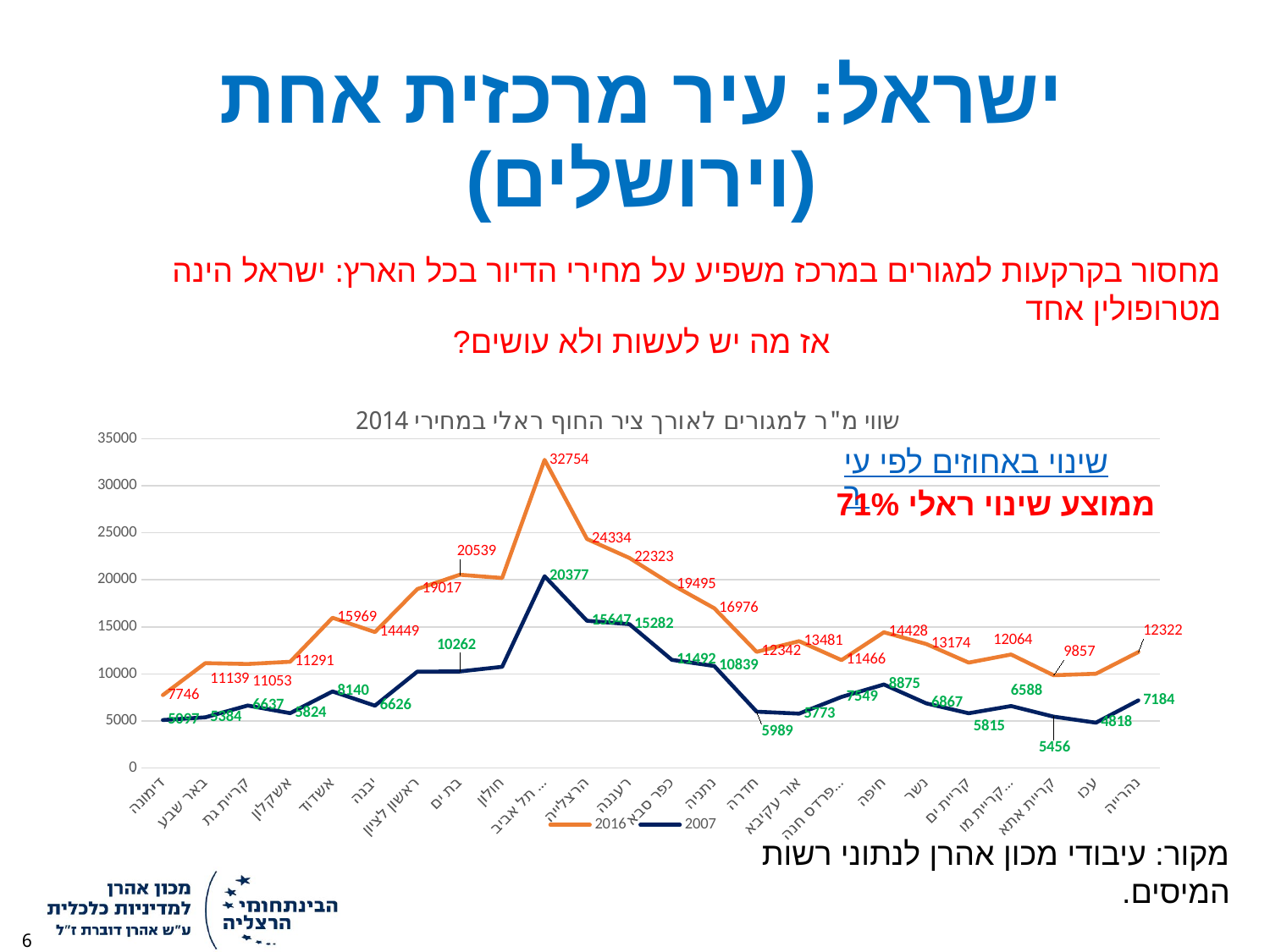
What is the difference between the 2016 and 2007 values for תל אביב? 12377 Which city has the highest 2016 value in the chart? תל אביב Which is larger for נתניה, the 2016 value or the 2007 value? 2016 Which colour represents the 2016 series in the chart? orange How many series does the chart legend list? 2 What is the 2016 value for הרצליה? 24334 What is the 2007 value for חיפה? 8875 Which city has the lowest 2016 value in the chart? דימונה Is the 2016 value for חולון greater or less than 15000? greater What is the 2016 value for תל אביב? 32754 What kind of chart is shown on the slide? line chart What is the 2007 value for תל אביב? 20377